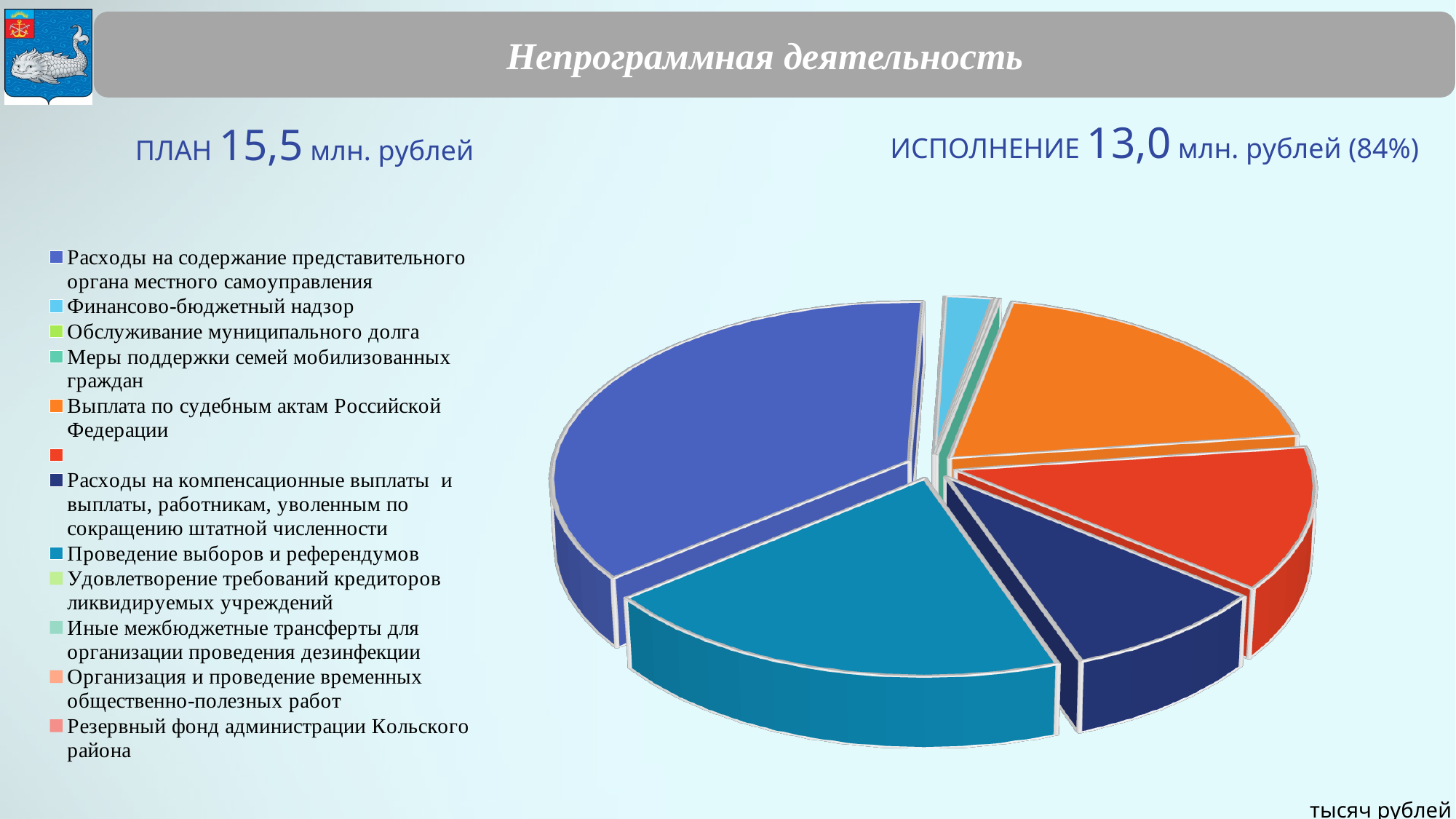
Which slice is larger: Расходы на содержание представительного органа местного самоуправления or Проведение выборов и референдумов? Расходы на содержание представительного органа местного самоуправления Which slice is larger: Меры поддержки семей мобилизованных граждан or Расходы на компенсационные выплаты и выплаты, работникам, уволенным по сокращению штатной численности? Расходы на компенсационные выплаты и выплаты, работникам, уволенным по сокращению штатной численности What is the title of the slide containing the pie chart? Непрограммная деятельность Which category has the largest slice in the pie chart? Расходы на содержание представительного органа местного самоуправления Which slice is larger: Выплата по судебным актам Российской Федерации or Финансово-бюджетный надзор? Выплата по судебным актам Российской Федерации How many entries does the legend of the pie chart list? 12 What colour is the slice for Проведение выборов и референдумов in the pie chart? teal What kind of chart is shown on the slide? pie chart